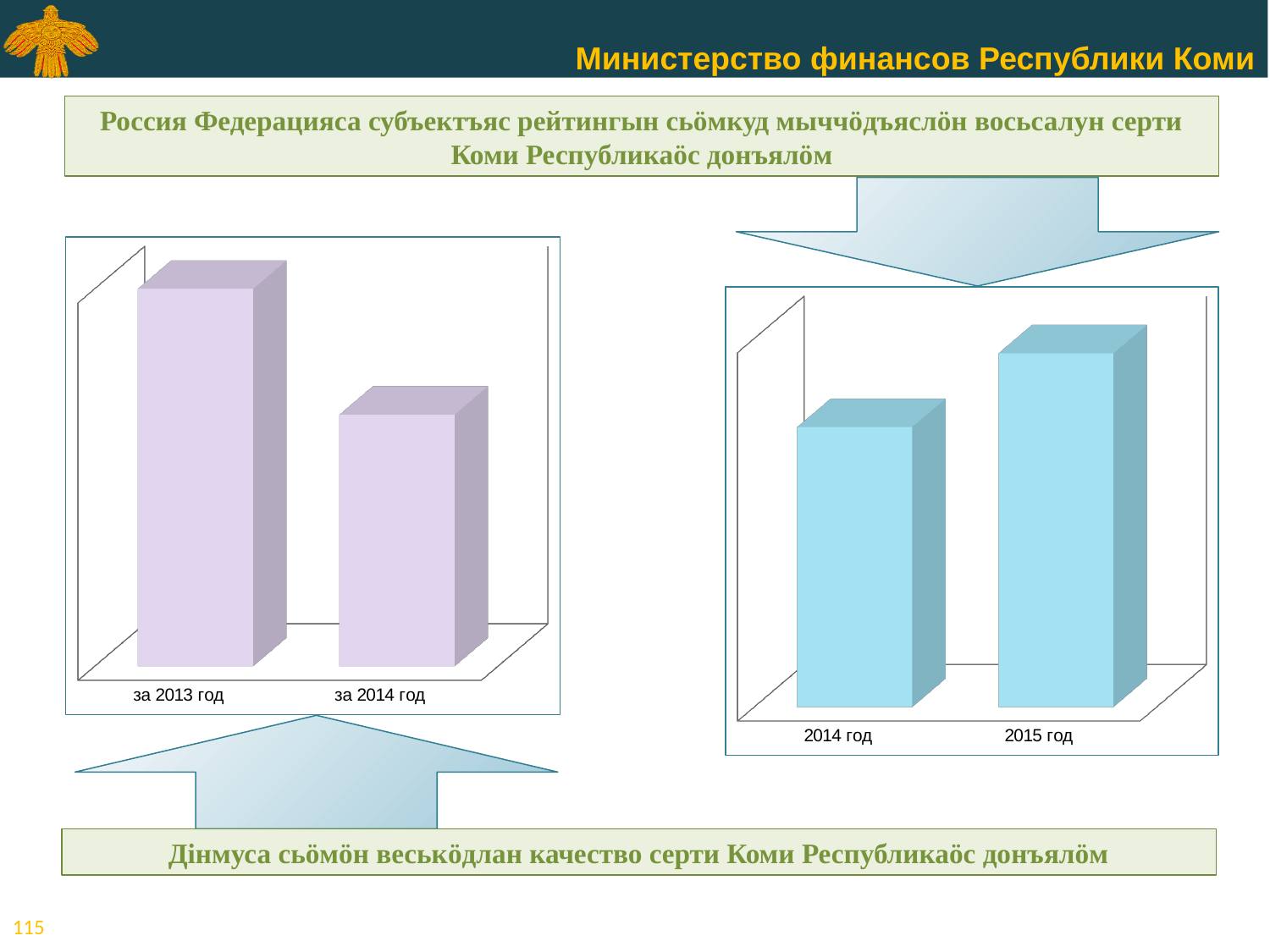
In the chart on the right, is the bar for 2014 год larger or smaller than the bar for 2015 год? smaller What kind of chart is the chart on the right of the slide? bar chart In the chart on the left, do the values rise or fall from за 2013 год to за 2014 год? fall In the chart on the right, how many categories are shown? 2 What kind of chart is the chart on the left of the slide? bar chart In the chart on the left, which category has the lowest bar? за 2014 год In the chart on the left, is the bar for за 2013 год larger or smaller than the bar for за 2014 год? larger In the chart on the right, do the values rise or fall from 2014 год to 2015 год? rise In the chart on the right, which category has the lowest bar? 2014 год In the chart on the left, how many categories are shown? 2 In the chart on the left, which category has the highest bar? за 2013 год In the chart on the right, which category has the highest bar? 2015 год